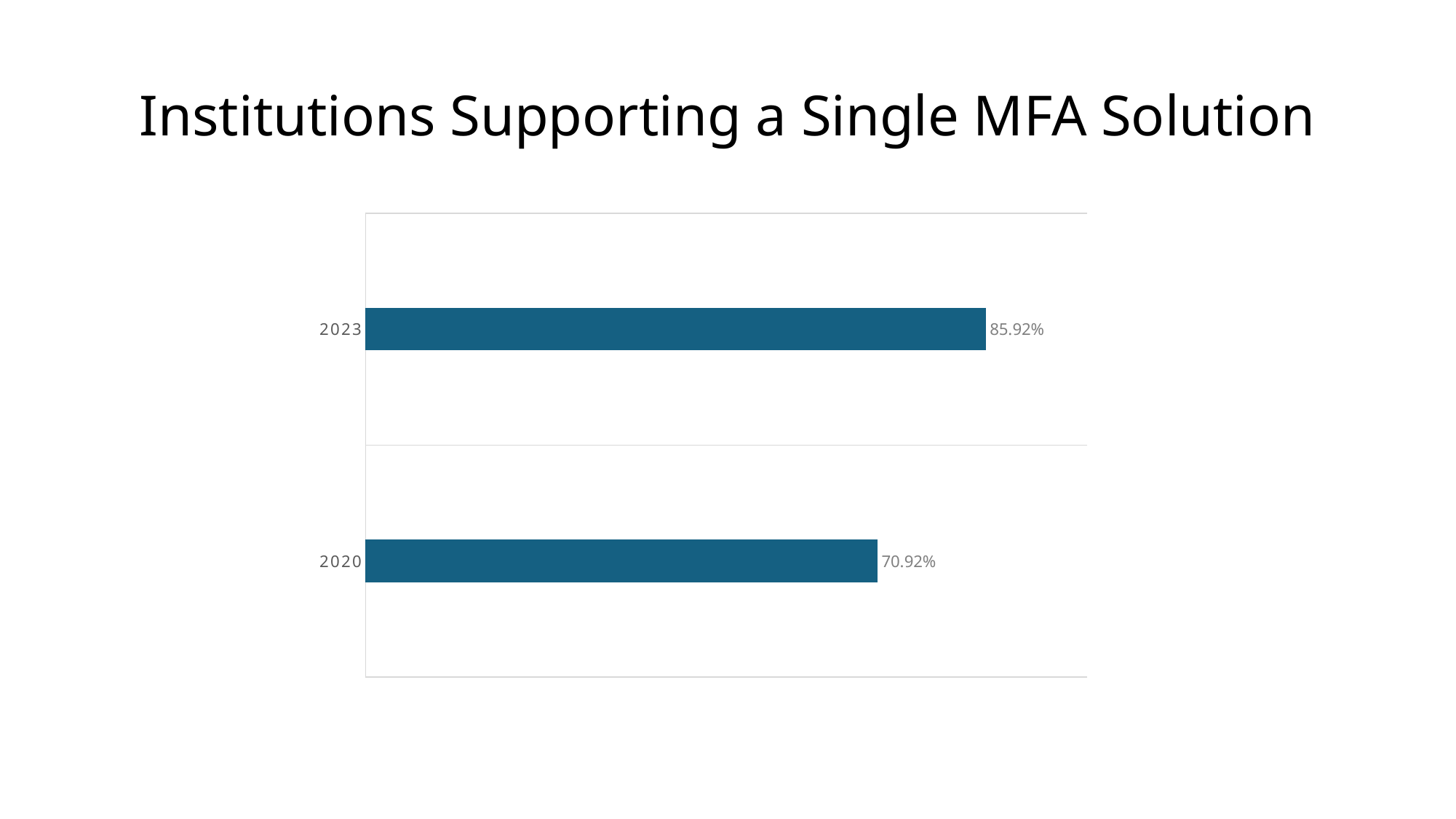
What is the title of the chart on the slide? Institutions Supporting a Single MFA Solution What kind of chart is shown on the slide? Bar chart What is the difference between the values for 2023 and 2020? 15.00% Are the bars in the chart horizontal or vertical? Horizontal Which year has the lowest value? 2020 What is the value for 2023? 85.92% How many categories are shown in the chart? 2 Which year has the highest value? 2023 Did the value rise or fall from 2020 to 2023? Rise What is the value for 2020? 70.92% Which is larger, the value for 2020 or the value for 2023? 2023